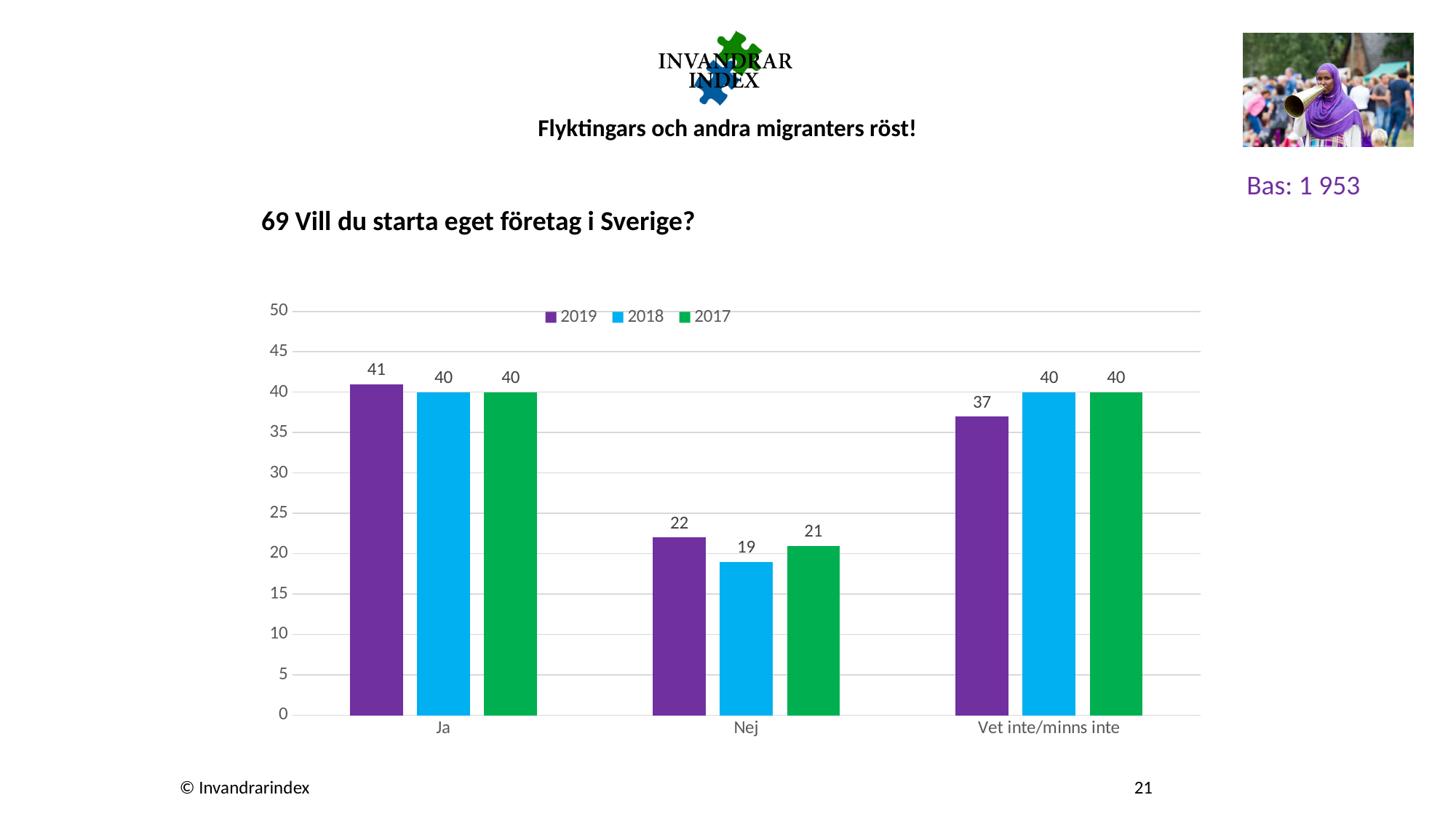
What is the value for 2018 in the Nej category? 19 What is the value for 2019 in the Vet inte/minns inte category? 37 What is the difference between the 2018 and 2019 values in the Vet inte/minns inte category? 3 Which is larger in the Nej category: the 2019 value or the 2017 value? 2019 How many categories are shown on the x axis? 3 Which category has the highest value for the 2019 series? Ja What kind of chart is shown on the slide? Bar chart How many series does the legend list? 3 What is the difference between the 2019 and 2018 values in the Nej category? 3 Which category has the lowest value for the 2018 series? Nej What is the value for 2019 in the Ja category? 41 What is the value for 2017 in the Nej category? 21